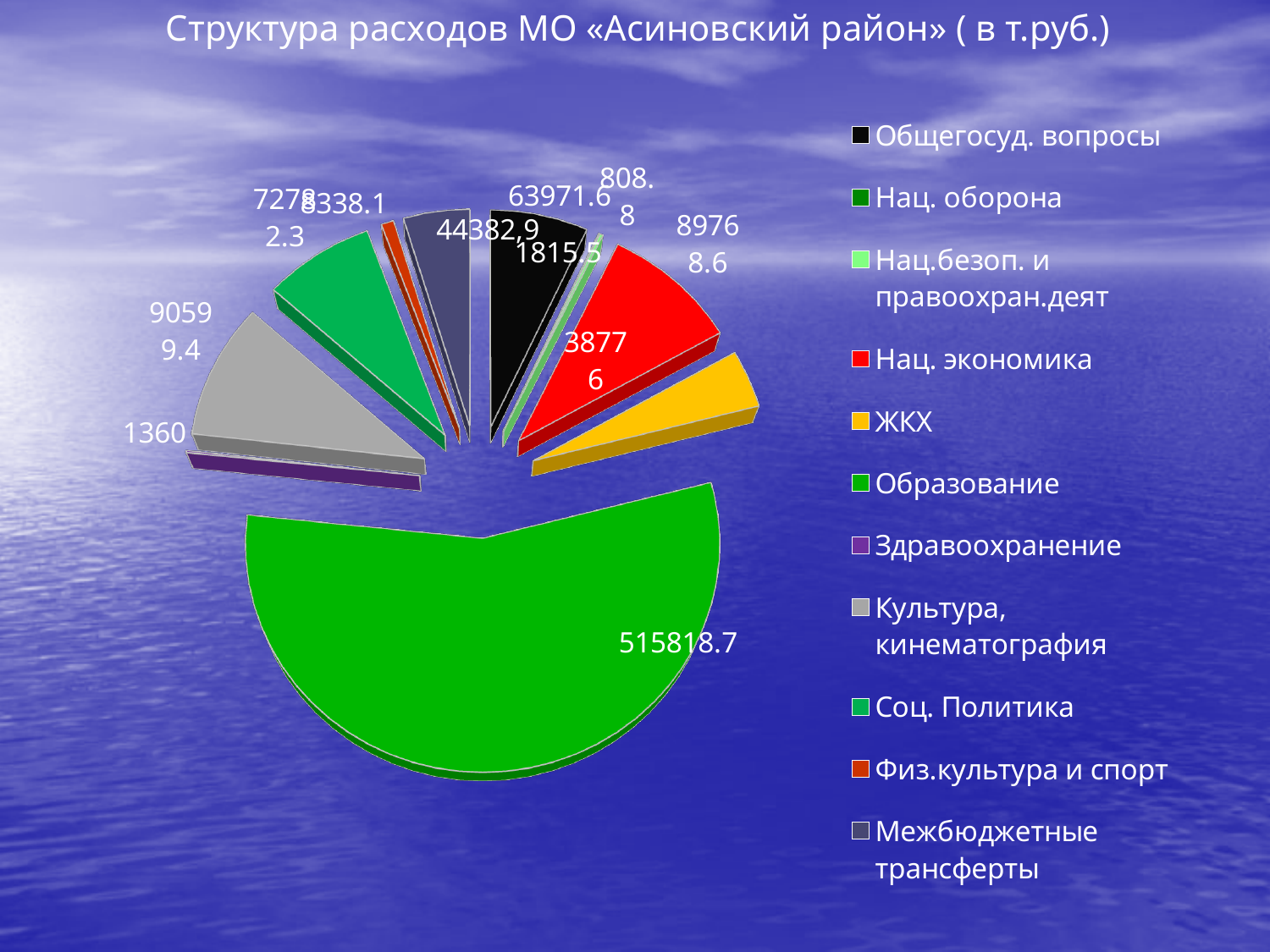
How many categories does the legend list? 11 Which category has the smallest value? Нац. оборона What is the value for Образование? 515818.7 Which category has the largest slice of the pie? Образование What type of chart is shown on the slide? pie chart Which is larger, the value for Общегосуд. вопросы or the value for Межбюджетные трансферты? Общегосуд. вопросы What is the difference between the values for Общегосуд. вопросы and Межбюджетные трансферты? 19588.7 What is the value for Здравоохранение? 1360 What is the value for Нац.безоп. и правоохран.деят? 1815.5 What is the value for ЖКХ? 38776 What is the value for Межбюджетные трансферты? 44382,9 What is the value for Общегосуд. вопросы? 63971.6